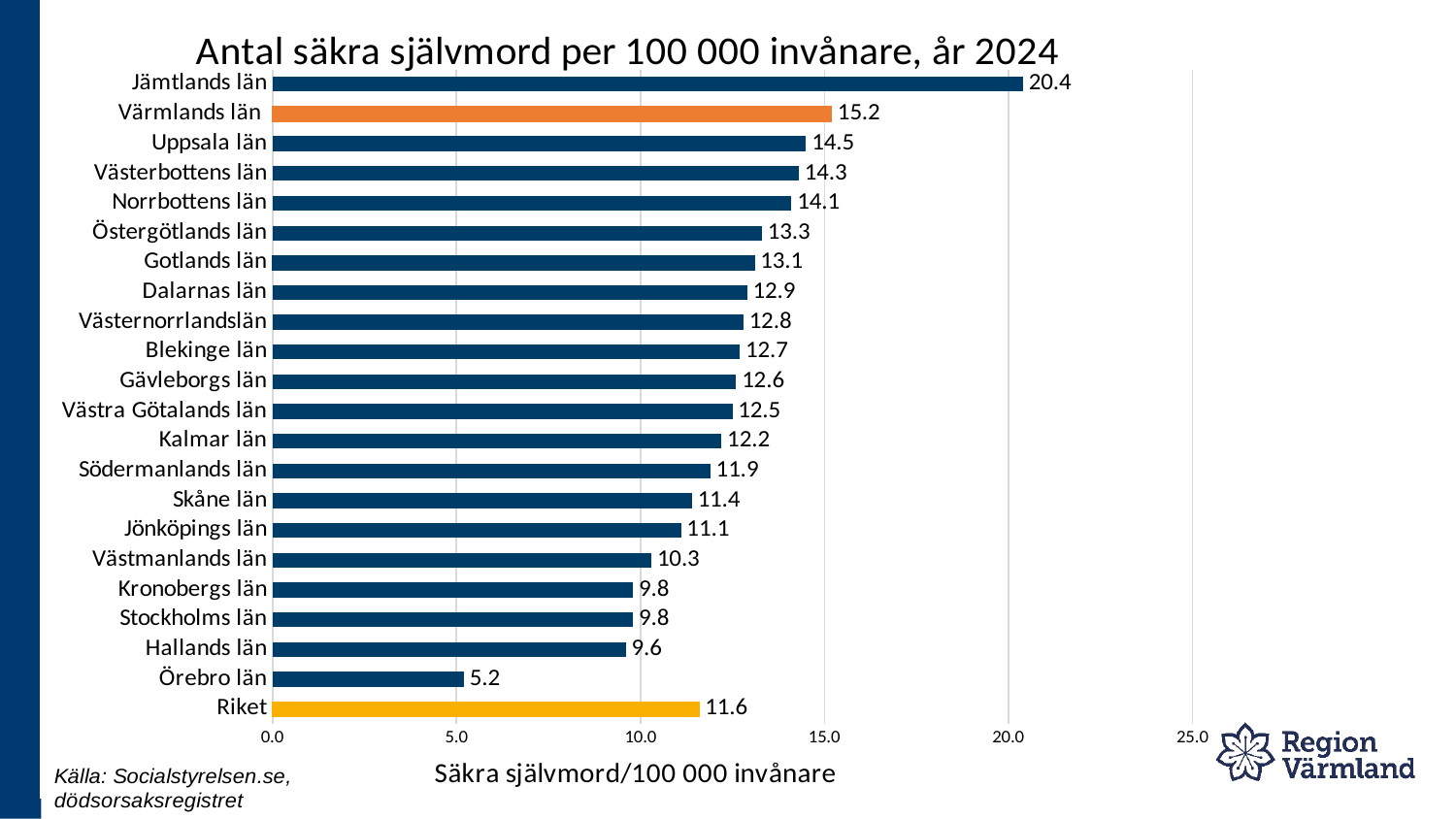
What is the difference between the values for Värmlands län and Riket? 3.6 What kind of chart is shown on the slide? bar chart What is the difference between the values for Jämtlands län and Värmlands län? 5.2 Which is larger, the value for Uppsala län or the value for Skåne län? Uppsala län Which category has the lowest value? Örebro län Which category has the highest value? Jämtlands län What is the value for Örebro län? 5.2 What is the value for Värmlands län? 15.2 How many categories are shown on the chart? 22 What is the title of the chart? Antal säkra självmord per 100 000 invånare, år 2024 Is the value for Hallands län greater or less than 10.0? less What is the value for Riket? 11.6